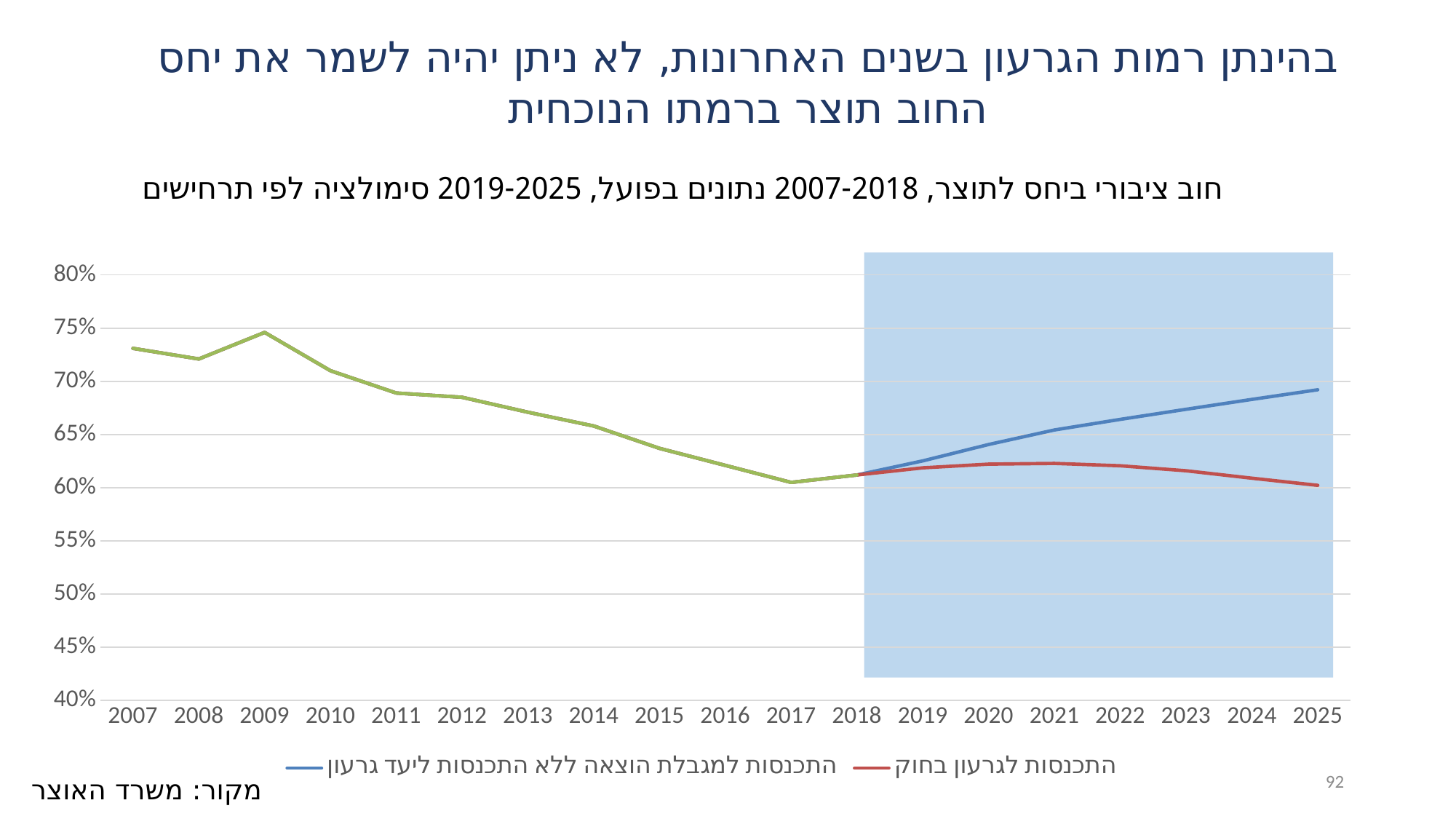
Is the value of the red line (התכנסות לגרעון בחוק) in 2025 greater or less than 65%? less Which year has the highest value on the chart? 2009 Which is larger, the value for 2009 or the value for 2017? 2009 In 2025, which series is higher: the blue line or the red line? the blue line How many series does the legend list? 2 How many years are shown on the x axis? 19 Is the value for 2017 greater or less than 65%? less Is the value of the blue line (התכנסות למגבלת הוצאה ללא התכנסות ליעד גרעון) in 2025 greater or less than 65%? greater What kind of chart is shown on the slide? line chart Does the line rise or fall from 2009 to 2017? fall Which years are covered by the shaded blue area on the chart? 2019-2025